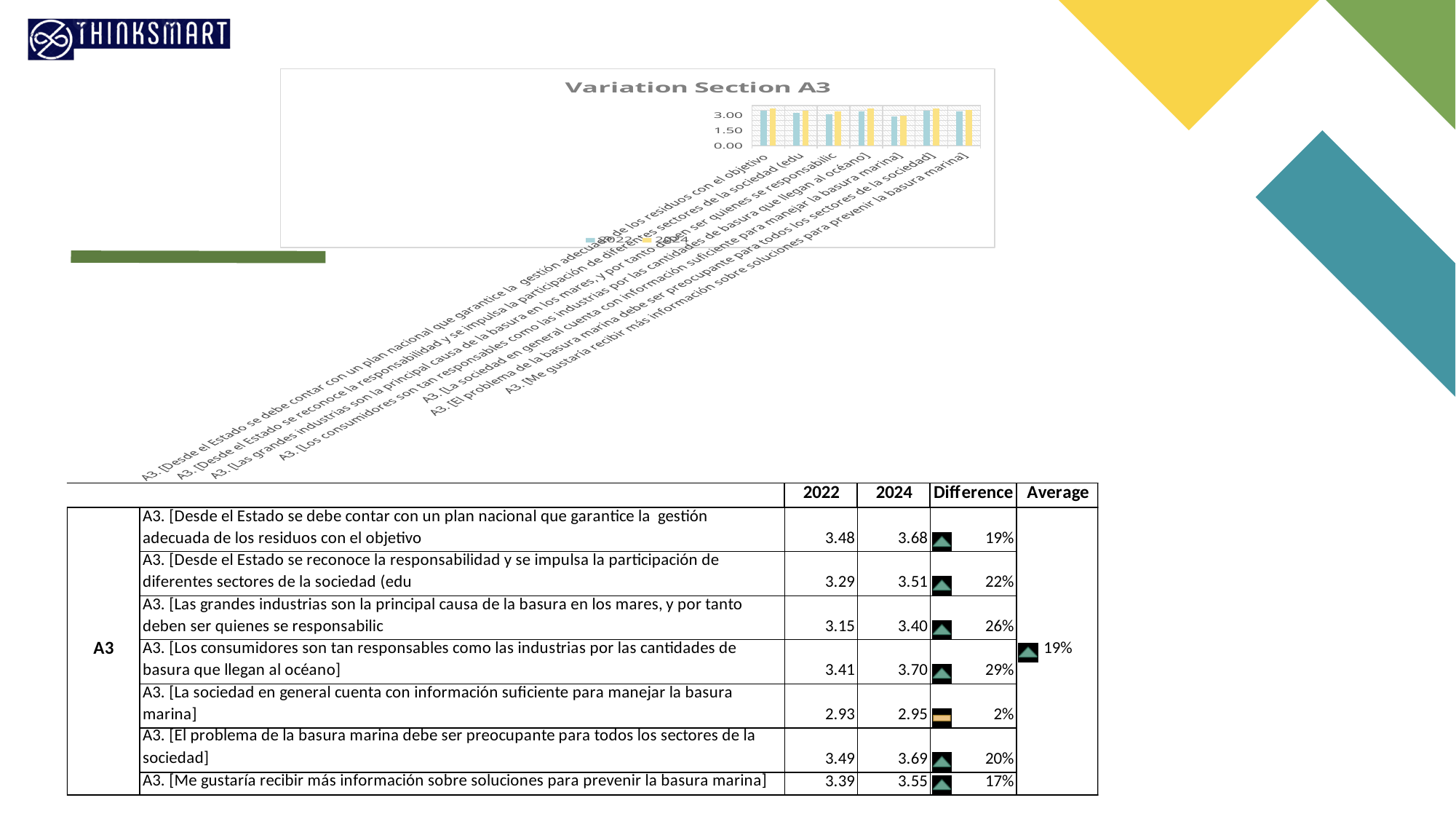
Which colour represents the 2024 series in the chart? yellow What is the 2024 value for 'A3. [Los consumidores son tan responsables como las industrias por las cantidades de basura que llegan al océano]'? 3.70 Which statement has the lowest 2024 value? A3. [La sociedad en general cuenta con información suficiente para manejar la basura marina] What is the difference between the 2024 and 2022 values for 'A3. [Los consumidores son tan responsables como las industrias por las cantidades de basura que llegan al océano]'? 0.29 Which statement has the lowest 2022 value? A3. [La sociedad en general cuenta con información suficiente para manejar la basura marina] What is the title of the chart? Variation Section A3 What kind of chart is shown on the slide? bar chart For 'A3. [Los consumidores son tan responsables como las industrias por las cantidades de basura que llegan al océano]', which is larger, the 2022 value or the 2024 value? 2024 How many series does the chart legend list? 2 What is the 2022 value for 'A3. [La sociedad en general cuenta con información suficiente para manejar la basura marina]'? 2.93 How many categories (statements) are plotted on the x axis of the chart? 7 Is the 2024 value for 'A3. [La sociedad en general cuenta con información suficiente para manejar la basura marina]' greater or less than 1.50? greater